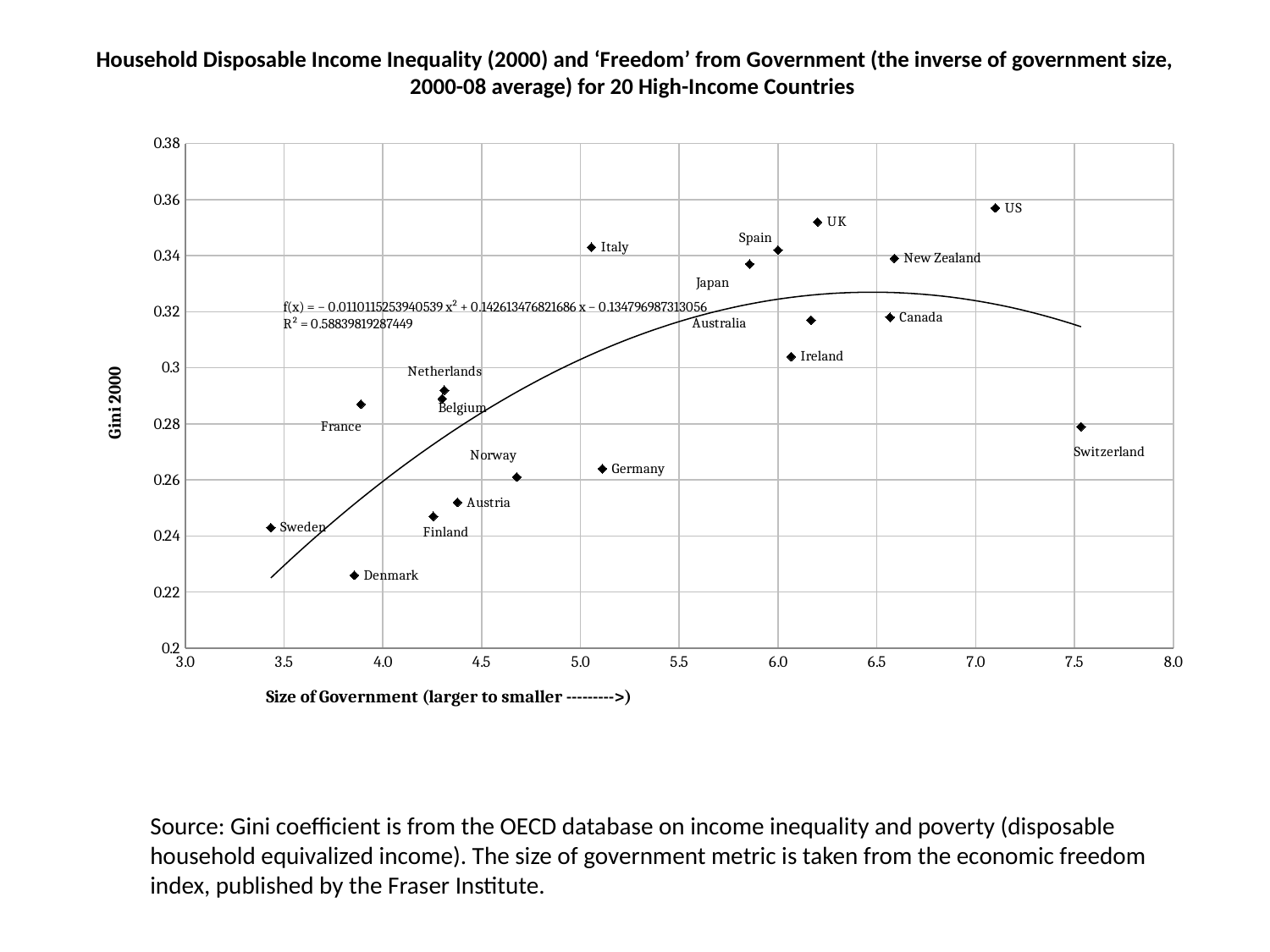
Which has the higher Gini 2000 value, Italy or Germany? Italy Which country has the highest Size of Government score (furthest right on the x axis)? Switzerland Is the Size of Government score for Switzerland greater or less than 7.0? greater Which has the higher Gini 2000 value, Canada or Ireland? Canada Which country has the lowest Gini 2000 value? Denmark Is the Gini 2000 value for Italy greater or less than 0.32? greater Is the Gini 2000 value for Denmark greater or less than 0.24? less What R-squared value is printed for the fitted curve? 0.58839819287449 What kind of chart is shown on the slide? Scatter chart Which country has the highest Gini 2000 value? US Which country has the lowest Size of Government score (furthest left on the x axis)? Sweden